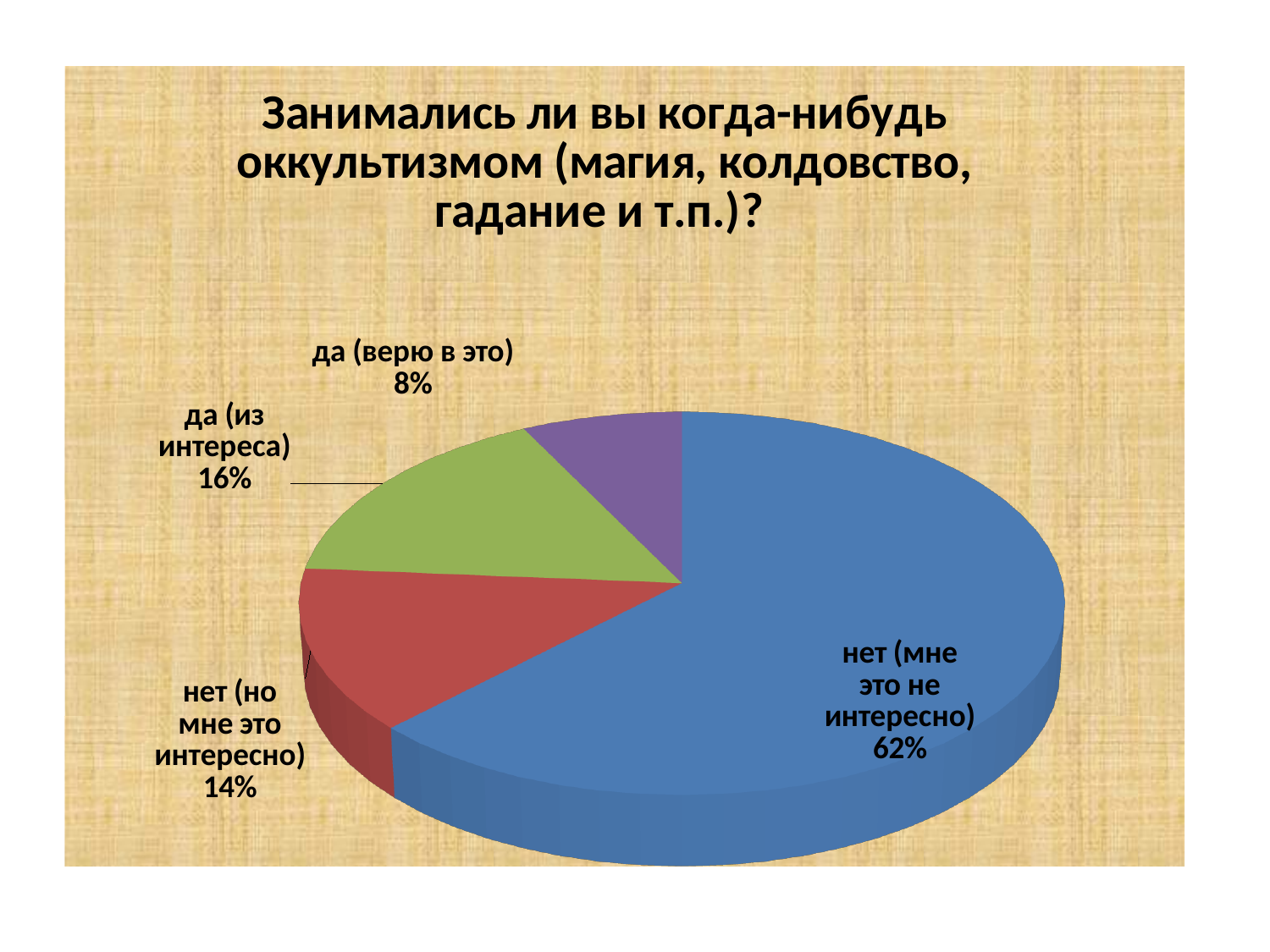
What kind of chart is shown on the slide? pie chart What share of the pie is labelled "нет (но мне это интересно)"? 14% What is the combined share of the two "да" categories? 24% How many slices does the pie chart have? 4 What is the difference between the shares for "нет (мне это не интересно)" and "да (из интереса)"? 46% What share of the pie is labelled "нет (мне это не интересно)"? 62% What share of the pie is labelled "да (верю в это)"? 8% Which is larger: the share for "да (из интереса)" or the share for "нет (но мне это интересно)"? да (из интереса) What share of the pie is labelled "да (из интереса)"? 16% Which category has the largest slice of the pie? нет (мне это не интересно) Which category has the smallest slice of the pie? да (верю в это) What colour is the slice for "нет (мне это не интересно)"? blue